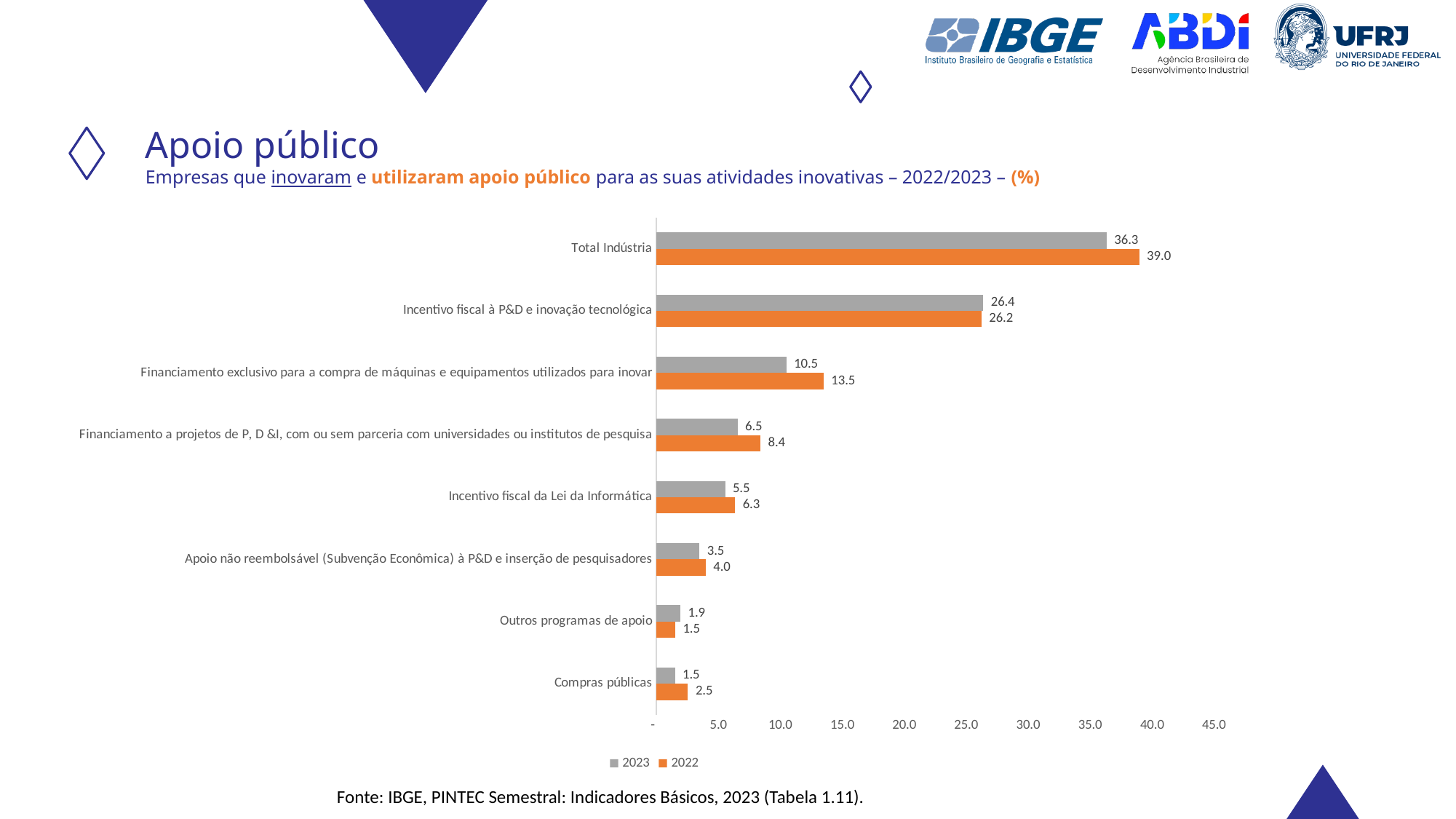
What is the difference between the 2022 and 2023 values for Financiamento exclusivo para a compra de máquinas e equipamentos utilizados para inovar? 3.0 For Outros programas de apoio, which year has the larger value, 2022 or 2023? 2023 What is the 2022 value for Compras públicas? 2.5 Which colour represents the 2022 series? Orange How many series does the legend list? 2 What is the 2022 value for Total Indústria? 39.0 How many categories are shown on the chart? 8 What is the difference between the 2022 and 2023 values for Total Indústria? 2.7 Which category has the lowest 2023 value? Compras públicas What is the 2023 value for Incentivo fiscal da Lei da Informática? 5.5 What kind of chart is shown on the slide? Bar chart Which category has the highest 2022 value? Total Indústria